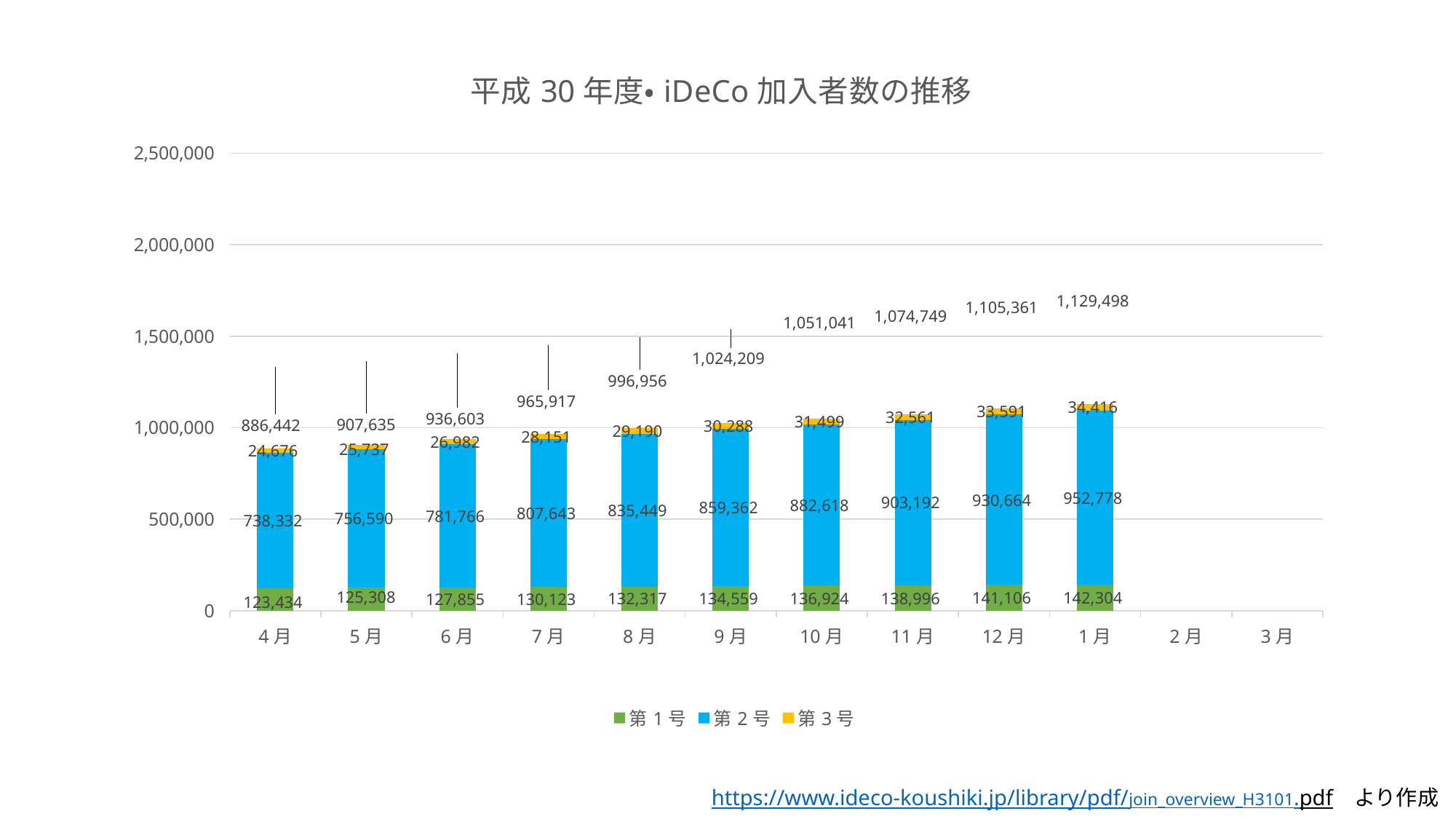
How many series does the legend list? 3 What is the value of 第3号 for 9月? 30,288 What is the value of 第1号 for 12月? 141,106 Which month with data has the lowest total number of subscribers? 4月 Which is larger, the 第1号 value for 7月 or the 第1号 value for 10月? 10月 Do the total values rise or fall from 4月 to 1月? Rise What is the total of the stacked bar for 1月? 1,129,498 Which month has the highest total number of subscribers? 1月 How many months on the x axis have bars plotted? 10 What is the difference between the 第2号 values for 1月 and 4月? 214,446 What is the value of 第2号 for 4月? 738,332 What kind of chart is shown on the slide? Stacked bar chart